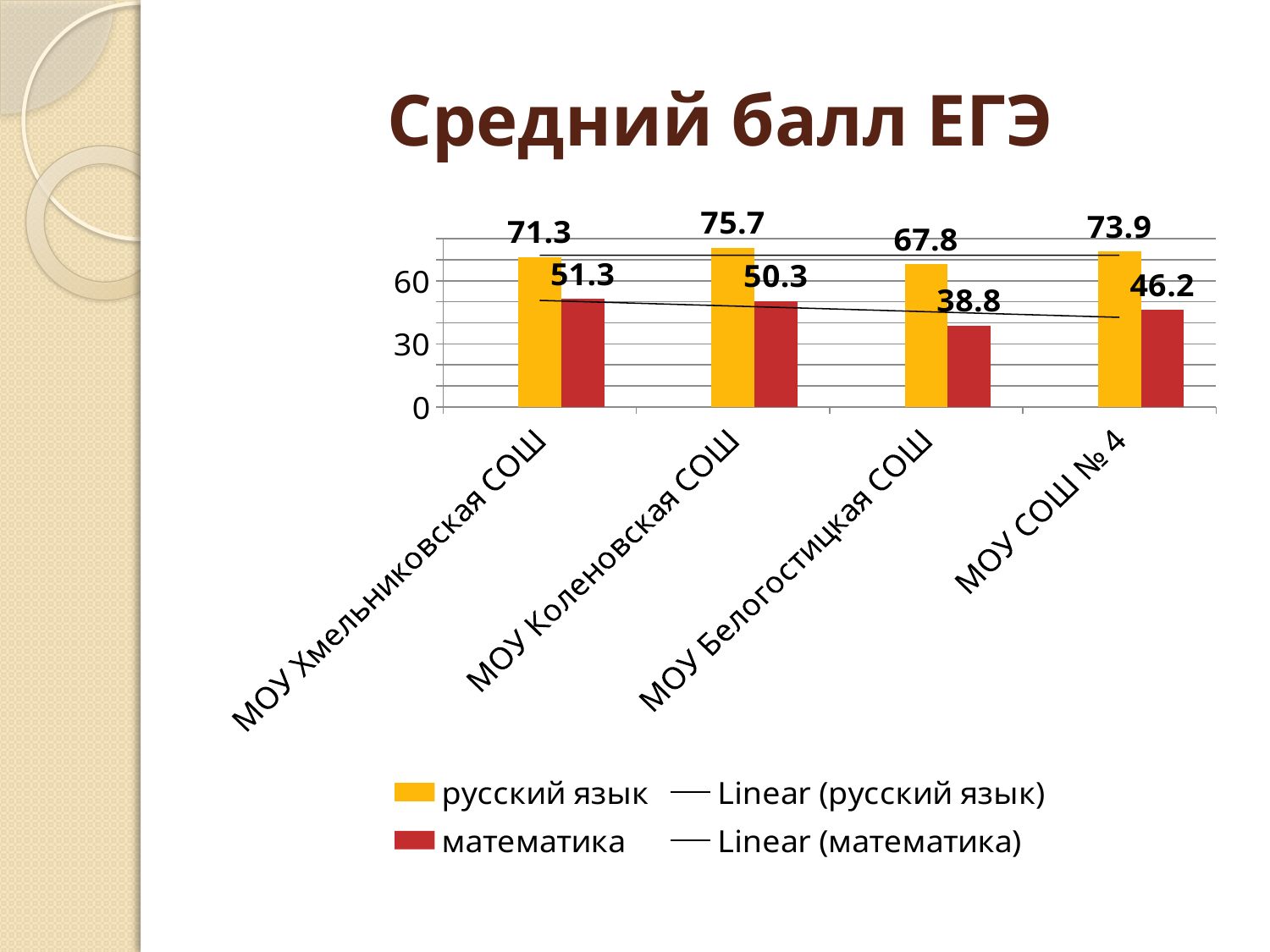
What is the difference between the русский язык and математика scores for МОУ Хмельниковская СОШ? 20 What is the title of the slide? Средний балл ЕГЭ What is the average EGE score in математика for МОУ Белогостицкая СОШ? 38.8 Which is larger: the математика score for МОУ Хмельниковская СОШ or for МОУ СОШ № 4? МОУ Хмельниковская СОШ What is the average EGE score in русский язык for МОУ Коленовская СОШ? 75.7 What is the average EGE score in математика for МОУ СОШ № 4? 46.2 Which school has the lowest average score in математика? МОУ Белогостицкая СОШ Which colour represents математика in the chart? red How many schools are shown on the x axis? 4 What kind of chart is shown on the slide? bar chart How many entries does the legend list? 4 Which school has the highest average score in русский язык? МОУ Коленовская СОШ